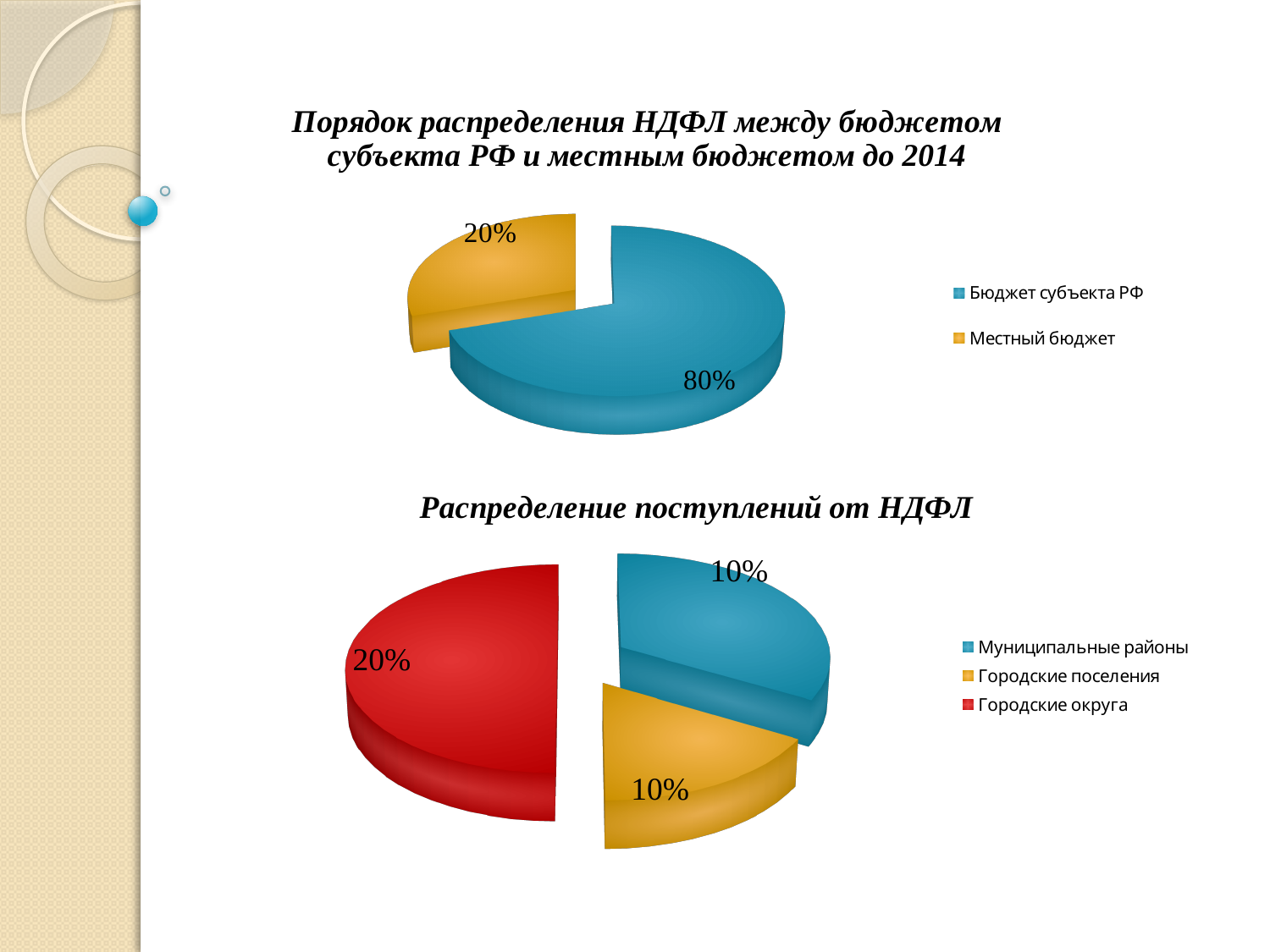
In the top chart, what share goes to Местный бюджет? 20% In the top chart, which category has the largest slice? Бюджет субъекта РФ In the top chart, how many slices does the pie have? 2 What type of chart is the top chart? Pie chart In the bottom chart (Распределение поступлений от НДФЛ), which colour represents Городские округа? Red In the bottom chart (Распределение поступлений от НДФЛ), which category has the largest slice? Городские округа In the bottom chart (Распределение поступлений от НДФЛ), how many categories does the legend list? 3 In the top chart, what is the difference between the shares of Бюджет субъекта РФ and Местный бюджет? 60% In the top chart, what share goes to Бюджет субъекта РФ? 80% In the bottom chart (Распределение поступлений от НДФЛ), what share is labelled for Муниципальные районы? 10% In the bottom chart (Распределение поступлений от НДФЛ), what share is labelled for Городские поселения? 10% In the bottom chart (Распределение поступлений от НДФЛ), what share is labelled for Городские округа? 20%